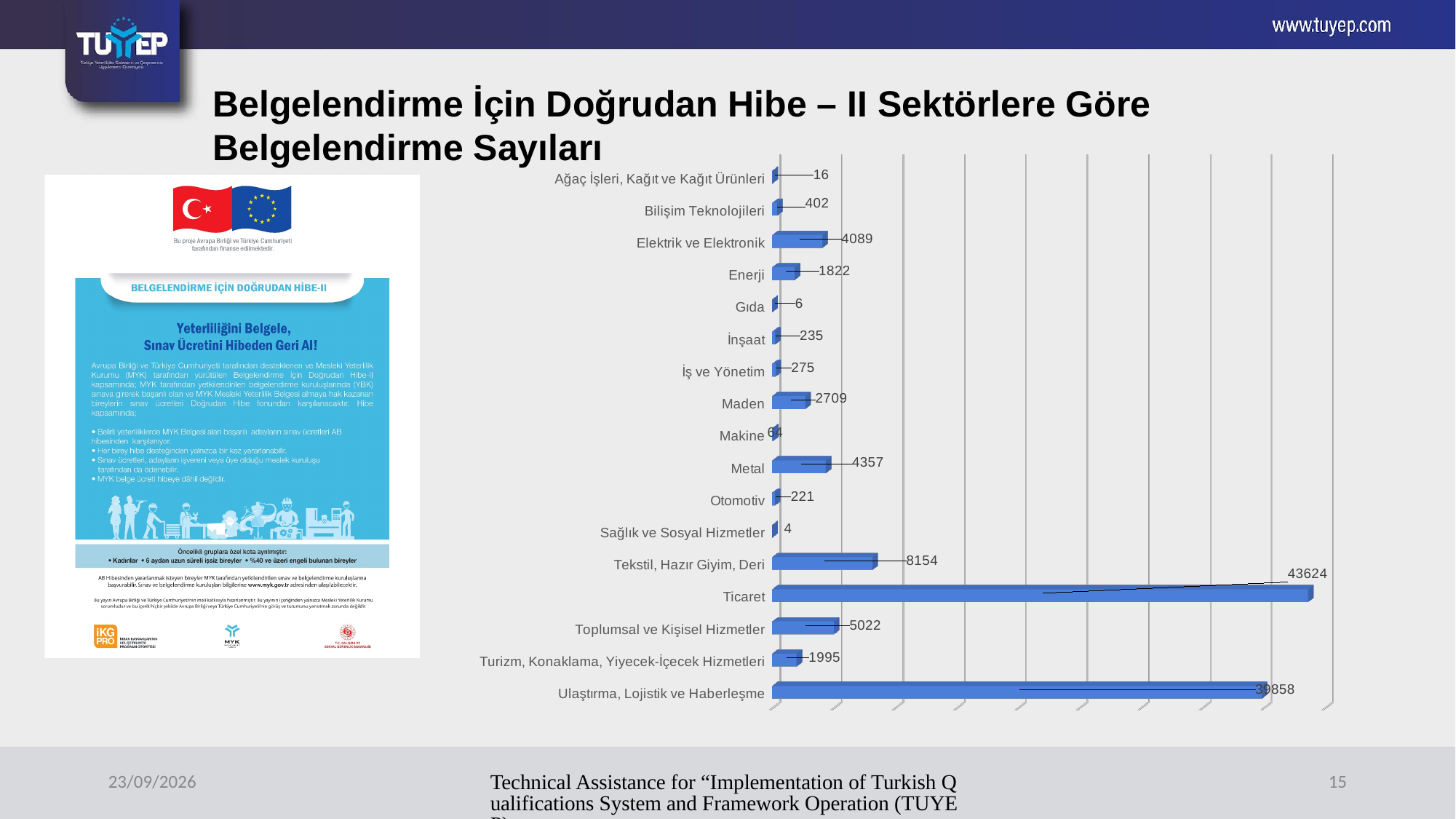
What is the difference between the values for Maden and Enerji? 887 What is the value for Gıda? 6 How many sectors (categories) are plotted in the chart? 17 Which is larger, the value for Elektrik ve Elektronik or the value for Toplumsal ve Kişisel Hizmetler? Toplumsal ve Kişisel Hizmetler What is the value for Ulaştırma, Lojistik ve Haberleşme? 39858 What is the value for Ticaret? 43624 What is the value for Metal? 4357 What is the difference between the values for Ticaret and Ulaştırma, Lojistik ve Haberleşme? 3766 Which sector has the highest value? Ticaret What is the value for Tekstil, Hazır Giyim, Deri? 8154 What kind of chart is shown on the slide? bar chart Which sector has the lowest value? Sağlık ve Sosyal Hizmetler